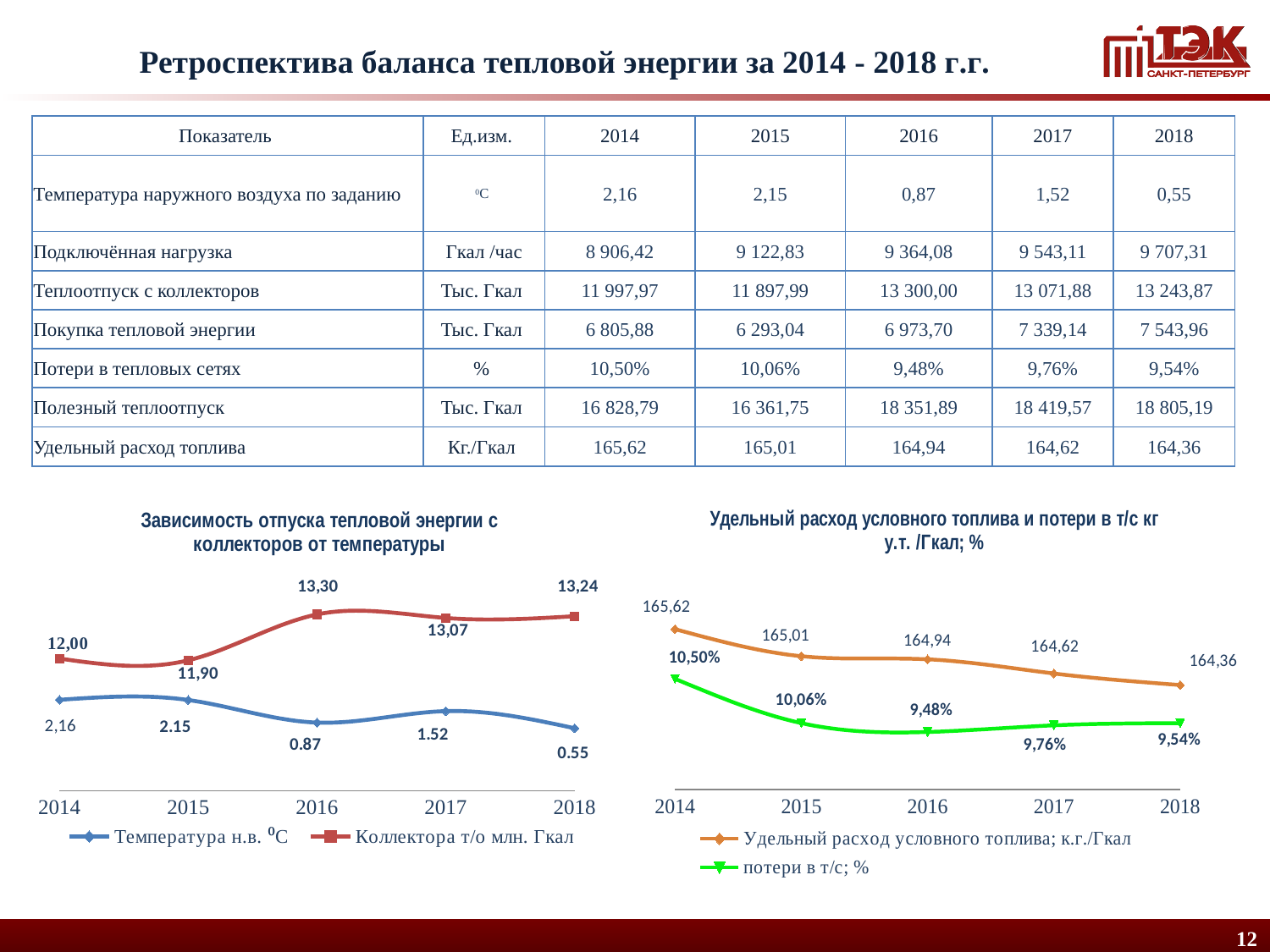
On the right chart 'Удельный расход условного топлива и потери в т/с', which year has the highest value of 'потери в т/с; %'? 2014 On the right chart 'Удельный расход условного топлива и потери в т/с', what is the value of 'Удельный расход условного топлива; к.г./Гкал' for 2017? 164,62 On the left chart 'Зависимость отпуска тепловой энергии с коллекторов от температуры', in which year is 'Коллектора т/о млн. Гкал' lowest? 2015 On the left chart 'Зависимость отпуска тепловой энергии с коллекторов от температуры', what is the difference between the 'Коллектора т/о млн. Гкал' values for 2016 and 2015? 1,40 On the left chart 'Зависимость отпуска тепловой энергии с коллекторов от температуры', how many series does the legend list? 2 On the left chart 'Зависимость отпуска тепловой энергии с коллекторов от температуры', in which year is 'Температура н.в.' highest? 2014 What type of chart is the right chart 'Удельный расход условного топлива и потери в т/с'? line chart On the right chart 'Удельный расход условного топлива и потери в т/с', what is the value of 'потери в т/с; %' for 2016? 9,48% On the right chart 'Удельный расход условного топлива и потери в т/с', is the 'потери в т/с; %' value for 2017 larger or smaller than for 2018? larger On the left chart 'Зависимость отпуска тепловой энергии с коллекторов от температуры', what is the value of 'Коллектора т/о млн. Гкал' for 2016? 13,30 On the left chart 'Зависимость отпуска тепловой энергии с коллекторов от температуры', what is the value of 'Температура н.в.' for 2018? 0.55 On the right chart 'Удельный расход условного топлива и потери в т/с', does 'Удельный расход условного топлива' rise or fall from 2014 to 2018? fall